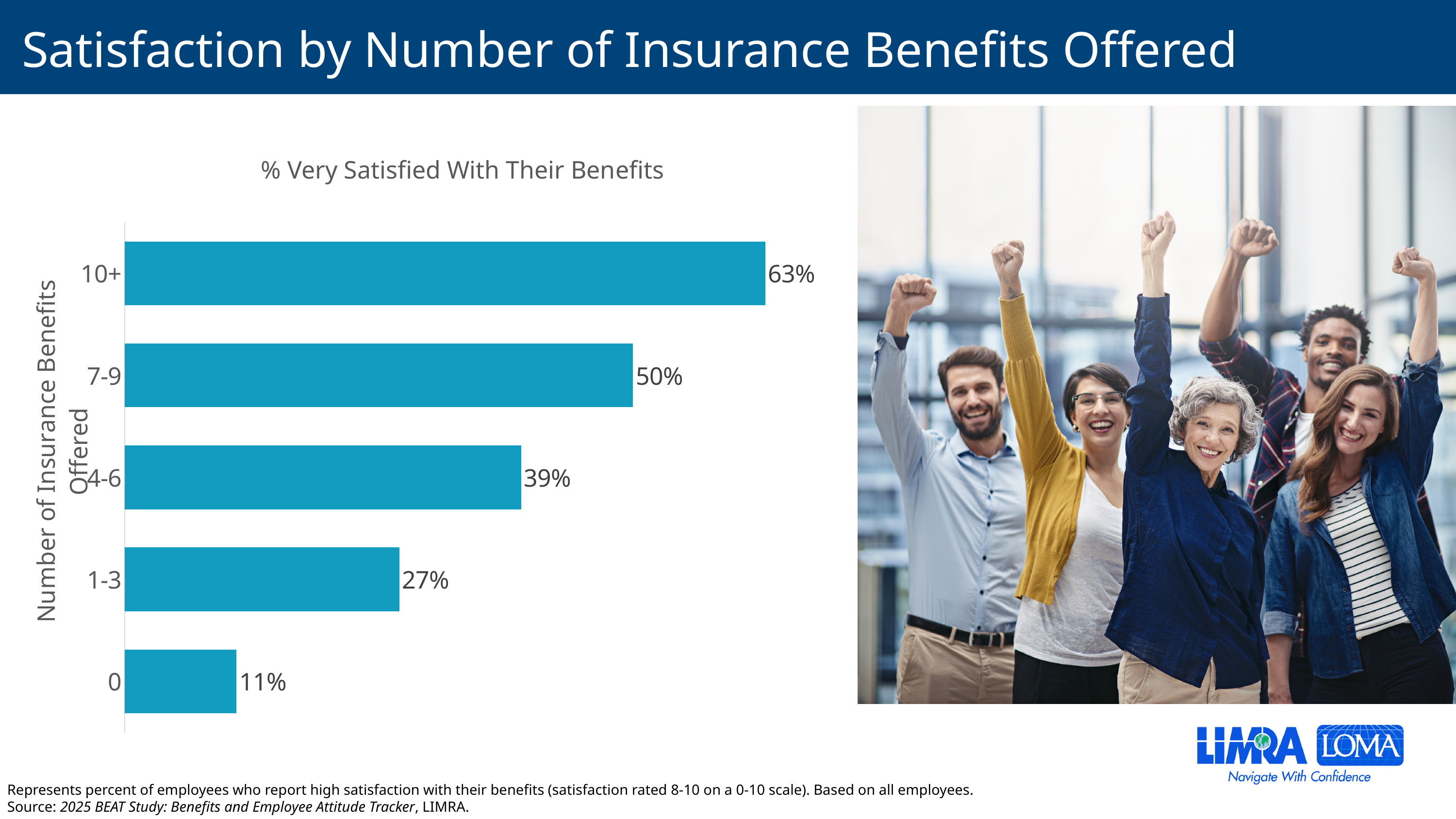
What percentage of employees offered 10+ insurance benefits are very satisfied with their benefits? 63% What percentage of employees offered 4-6 insurance benefits are very satisfied? 39% What type of chart is used on this slide? Bar chart Which number-of-benefits category has the highest share of very satisfied employees? 10+ What is the difference in percentage points between the 10+ category and the 0 category? 52 How many categories of number of insurance benefits offered are shown in the chart? 5 Which category has the lowest percentage of very satisfied employees? 0 What is the value for the 7-9 benefits category? 50% What is the value shown for employees offered 0 insurance benefits? 11% Which has a higher value, the 4-6 category or the 1-3 category? 4-6 What is the title of the chart? % Very Satisfied With Their Benefits What is the difference between the 7-9 and 1-3 categories? 23